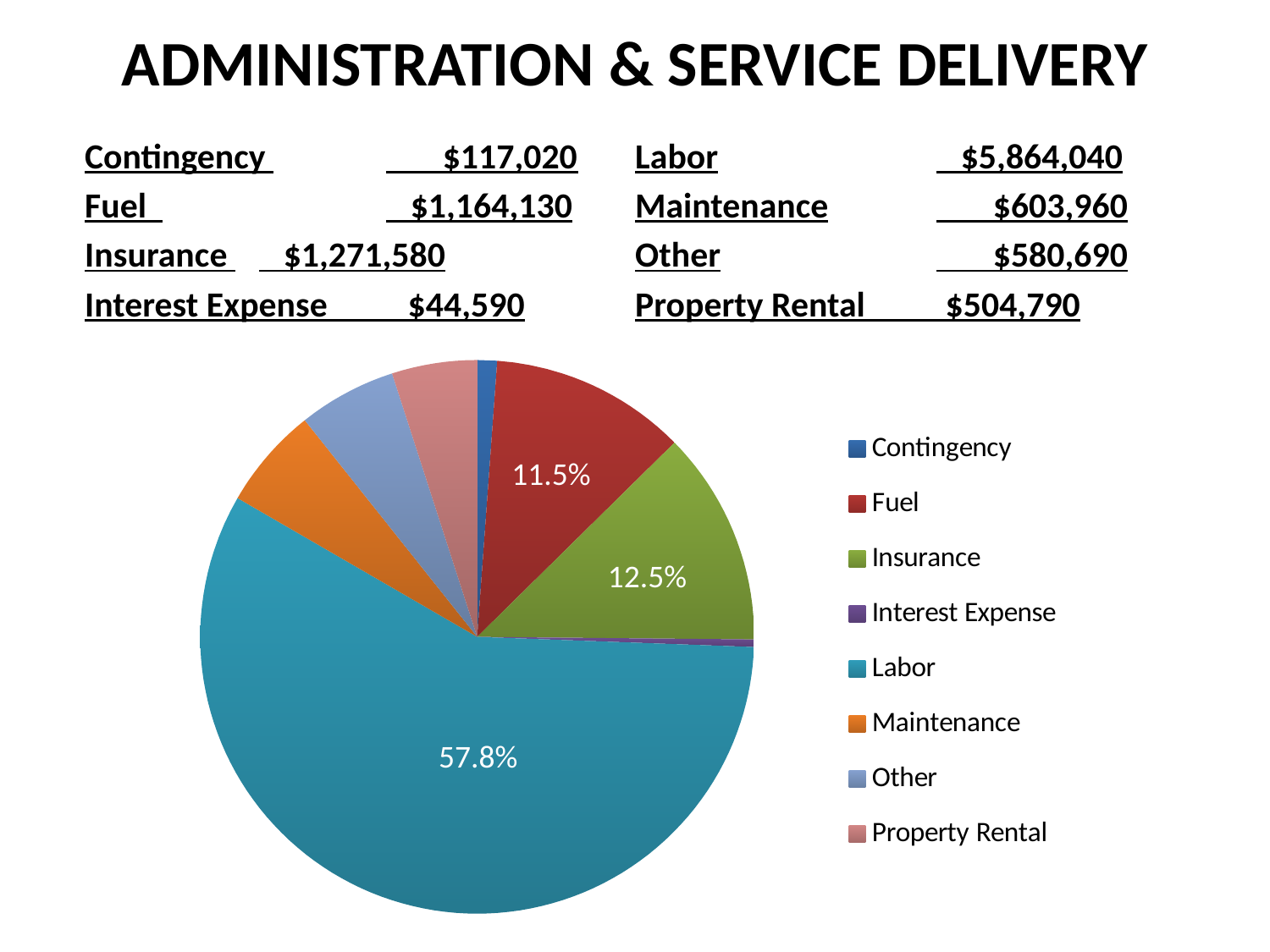
What colour is the Labor slice in the pie chart? teal Which slice is larger, Labor or Maintenance? Labor What is the difference in percentage points between the Insurance and Fuel slices? 1.0% What share of the pie does Fuel represent? 11.5% Which slice is larger, Insurance or Fuel? Insurance What share of the pie does Labor represent? 57.8% Which category has the largest slice of the pie? Labor Which category has the smallest slice of the pie? Interest Expense What share of the pie does Insurance represent? 12.5% How many categories does the legend of the pie chart list? 8 What kind of chart is shown on the slide? pie chart What is the title of the slide containing the pie chart? ADMINISTRATION & SERVICE DELIVERY